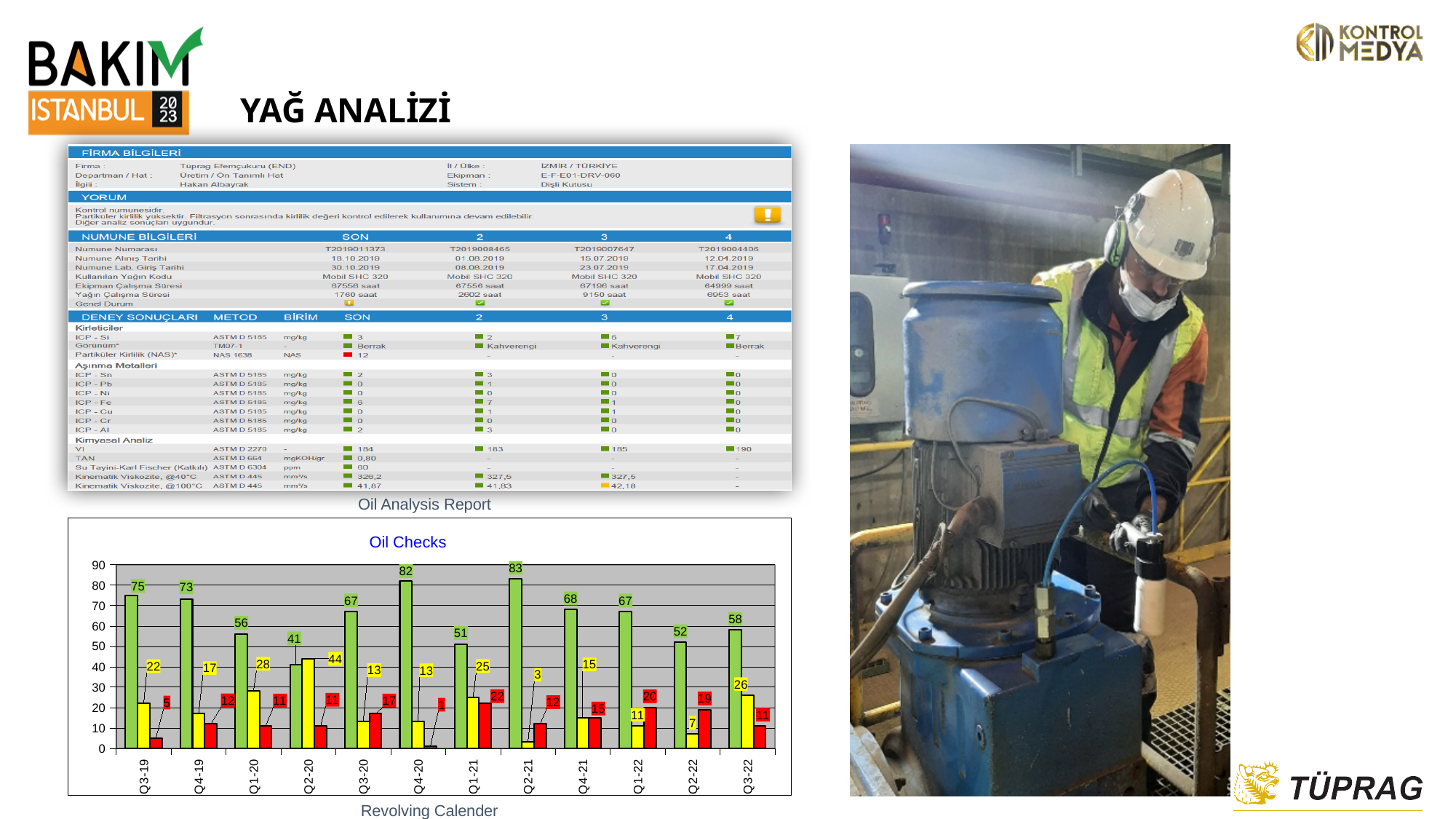
In the 'Oil Checks' chart, what is the value of the yellow bar for Q2-20? 44 In the 'Oil Checks' chart, what is the value of the red bar for Q1-22? 20 In the 'Oil Checks' chart, is the green bar for Q2-20 greater or less than 50? less In the 'Oil Checks' chart, is the yellow bar for Q3-22 larger than the yellow bar for Q2-22? Yes What type of chart is the 'Oil Checks' chart? bar chart In the 'Oil Checks' chart, which quarter has the highest green bar? Q2-21 In the 'Oil Checks' chart, what is the value of the yellow bar for Q2-21? 3 In the 'Oil Checks' chart, what is the difference between the green bar values for Q3-19 and Q1-20? 19 In the 'Oil Checks' chart, what is the value of the green bar for Q4-20? 82 In the 'Oil Checks' chart, which quarter has the lowest red bar? Q4-20 What is the title of the bar chart on the slide? Oil Checks How many quarter categories are shown on the x axis of the 'Oil Checks' chart? 12